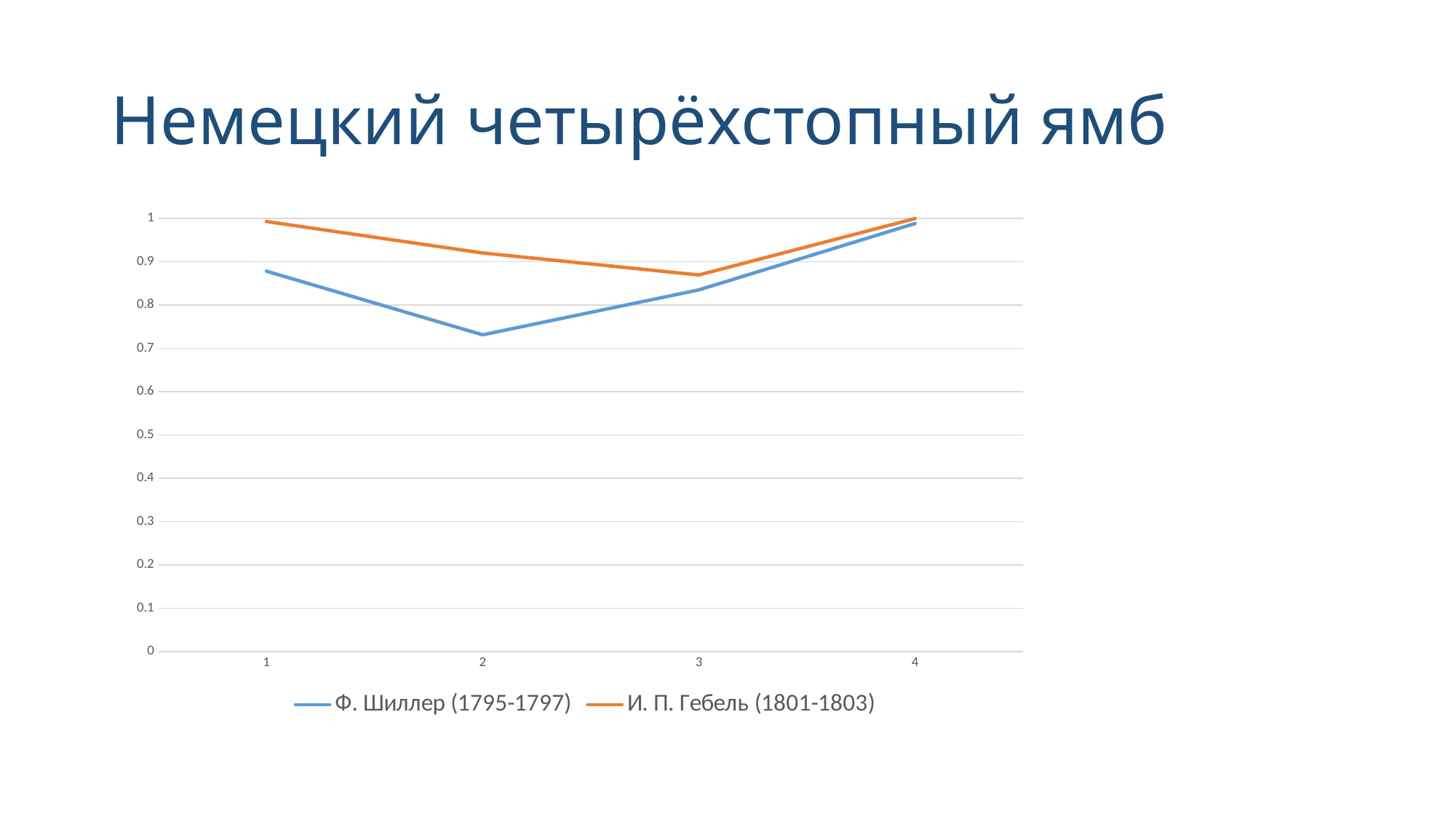
Is the value for И. П. Гебель (1801-1803) at position 3 greater or less than 0.9? less At position 2, which series has the larger value, Ф. Шиллер (1795-1797) or И. П. Гебель (1801-1803)? И. П. Гебель (1801-1803) How many points are plotted along the x axis for each series? 4 What kind of chart is shown on the slide? line chart At which position does the Ф. Шиллер (1795-1797) series reach its lowest value? 2 Is the value for И. П. Гебель (1801-1803) at position 1 greater or less than 0.9? greater Is the value for Ф. Шиллер (1795-1797) at position 2 greater or less than 0.8? less What is the title of the slide containing the chart? Немецкий четырёхстопный ямб How many series does the legend list? 2 At which position does the И. П. Гебель (1801-1803) series reach its lowest value? 3 Does the Ф. Шиллер (1795-1797) series rise or fall from position 3 to position 4? rise